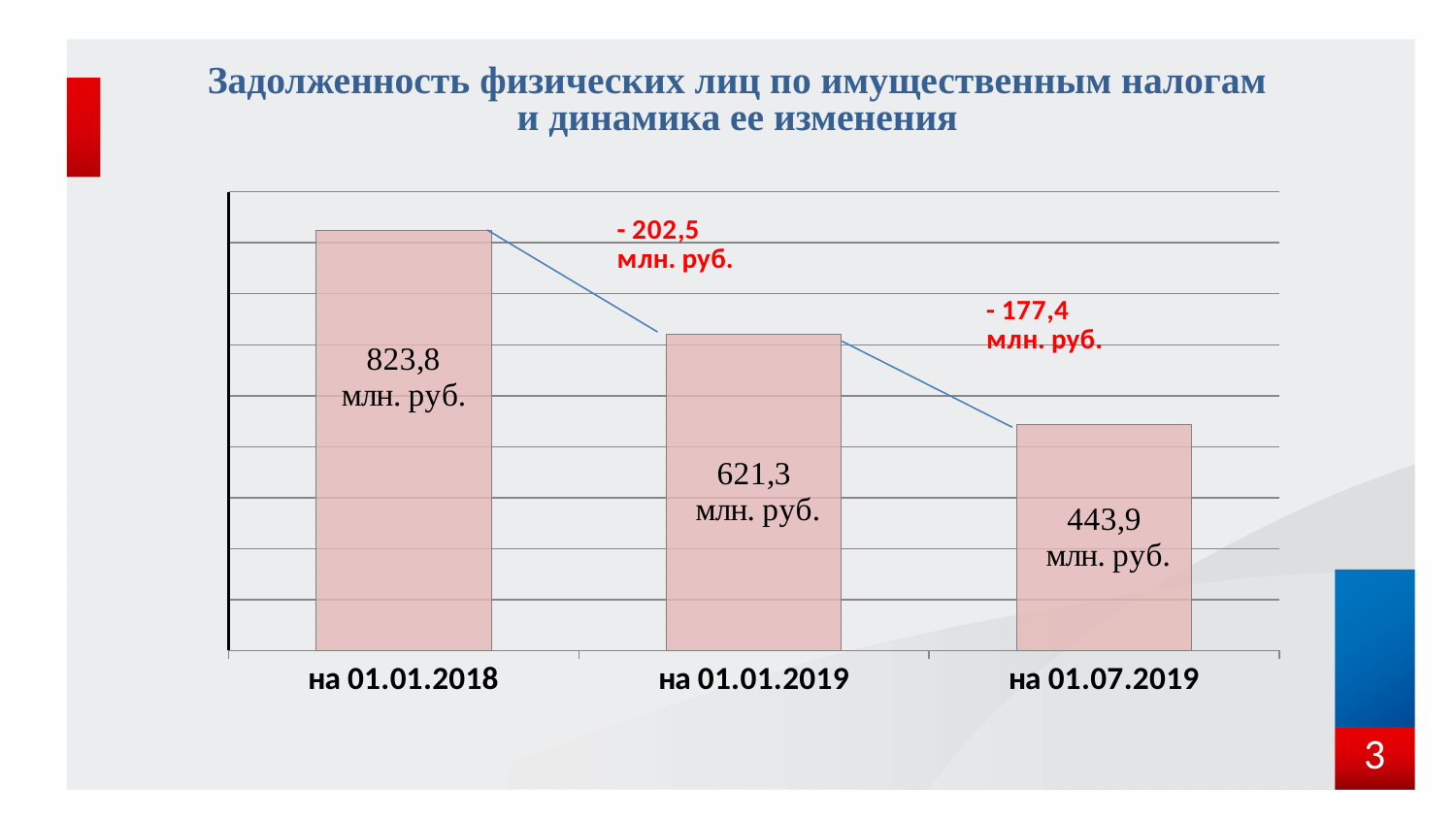
Do the values rise or fall from на 01.01.2018 to на 01.07.2019? fall What is the value for на 01.07.2019? 443,9 млн. руб. Which date has the lowest value? на 01.07.2019 What is the difference between the values for на 01.01.2018 and на 01.01.2019? 202,5 млн. руб. What kind of chart is shown on the slide? bar chart What is the value for на 01.01.2018? 823,8 млн. руб. What is the difference between the values for на 01.01.2019 and на 01.07.2019? 177,4 млн. руб. How many bars are shown in the chart? 3 Which date has the highest value? на 01.01.2018 Which is larger, the value for на 01.01.2019 or the value for на 01.07.2019? на 01.01.2019 What is the value for на 01.01.2019? 621,3 млн. руб. What is the difference between the values for на 01.01.2018 and на 01.07.2019? 379,9 млн. руб.